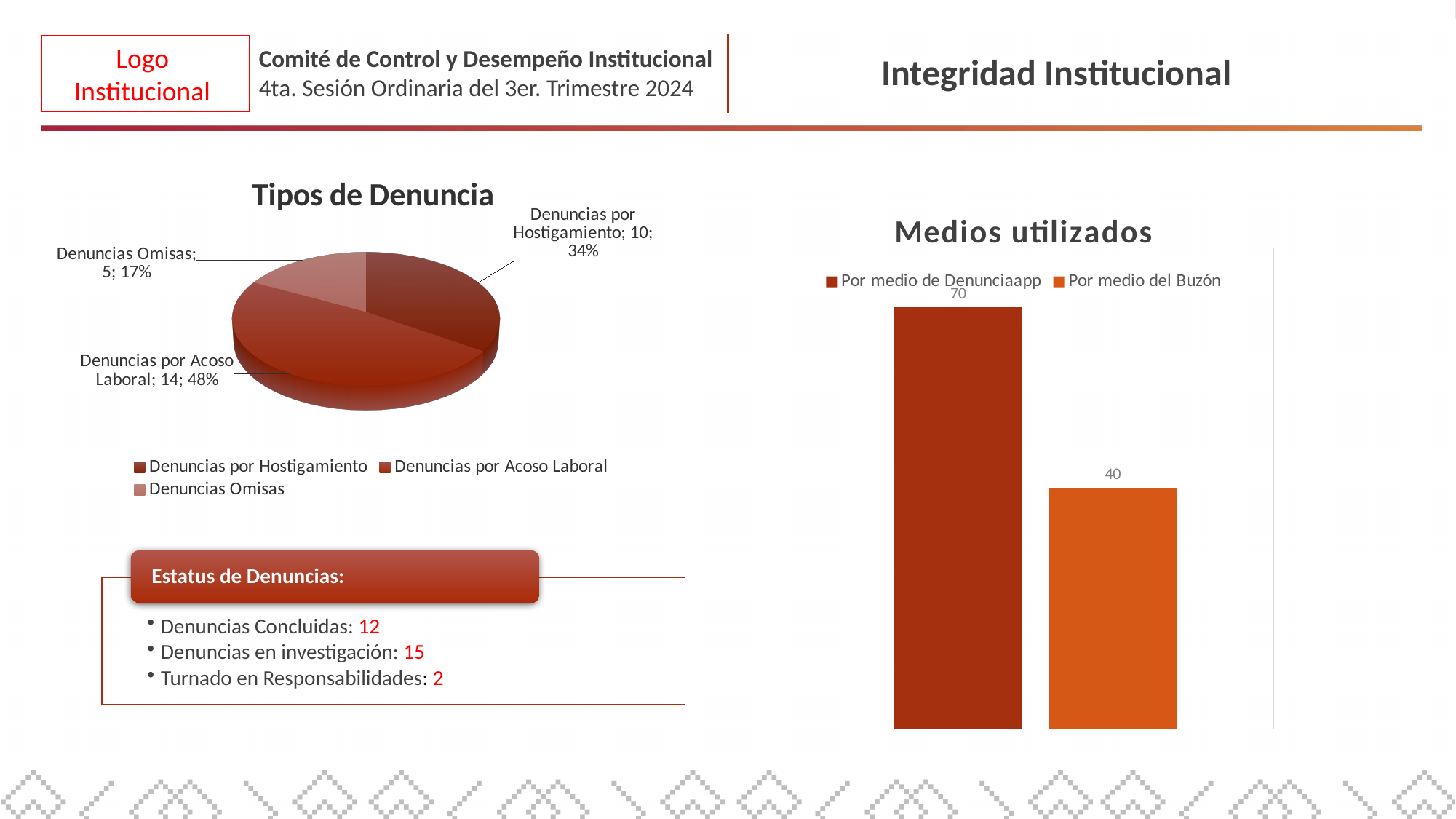
In the 'Tipos de Denuncia' chart, what is the value for Denuncias Omisas? 5 In the 'Medios utilizados' chart, what is the value for Por medio de Denunciaapp? 70 In the 'Tipos de Denuncia' chart, how many categories are shown? 3 In the 'Tipos de Denuncia' chart, what percentage share does Denuncias por Hostigamiento have? 34% In the 'Medios utilizados' chart, what is the difference between Por medio de Denunciaapp and Por medio del Buzón? 30 What kind of chart is 'Tipos de Denuncia'? Pie chart How many series does the legend of the 'Medios utilizados' chart list? 2 In the 'Tipos de Denuncia' chart, which category has the largest slice? Denuncias por Acoso Laboral In the 'Tipos de Denuncia' chart, which category has the smallest slice? Denuncias Omisas In the 'Tipos de Denuncia' chart, what is the value for Denuncias por Acoso Laboral? 14 In the 'Tipos de Denuncia' chart, what is the difference between the values for Denuncias por Acoso Laboral and Denuncias por Hostigamiento? 4 In the 'Medios utilizados' chart, what is the value for Por medio del Buzón? 40